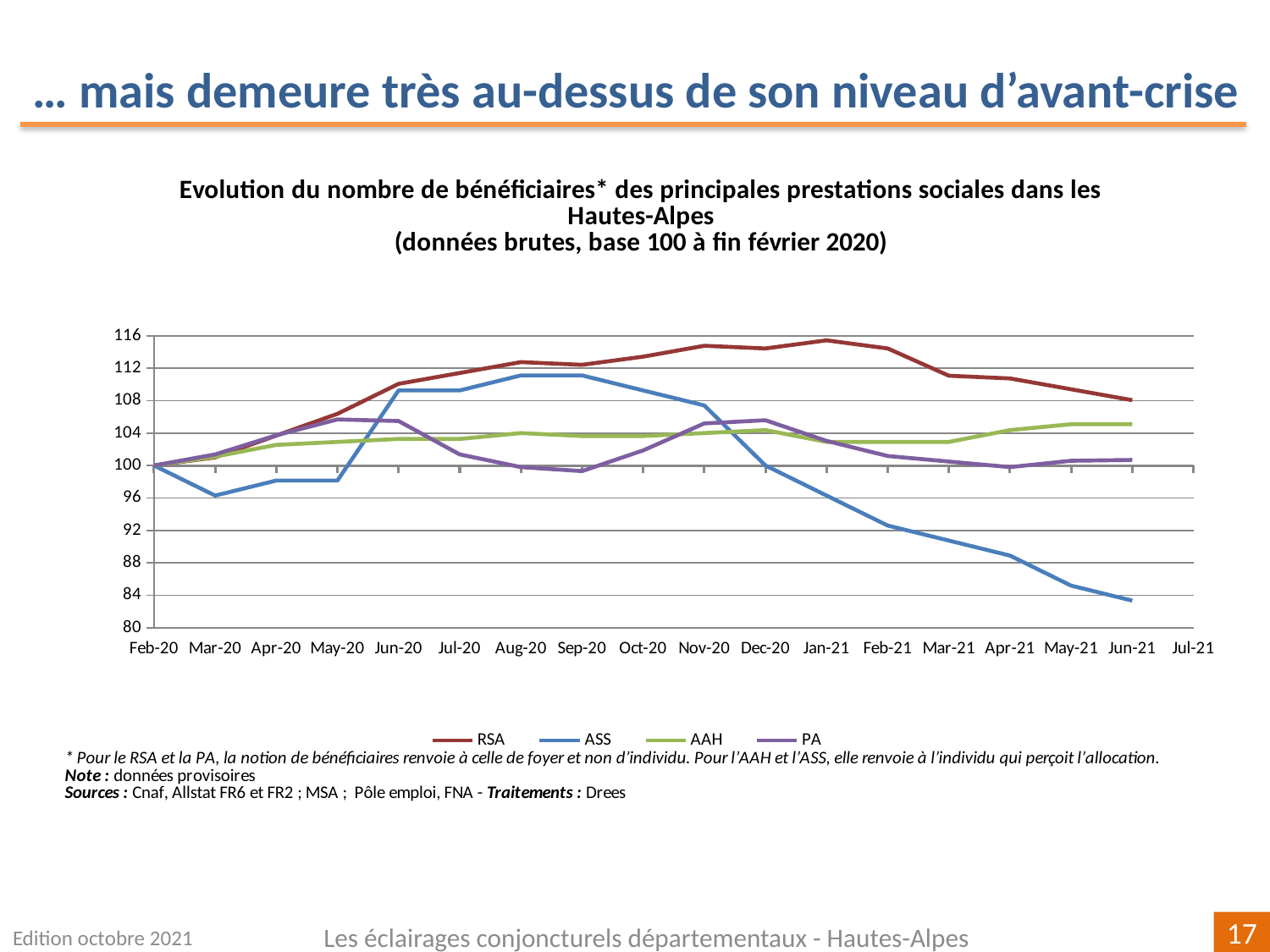
Is the value for ASS in Mar-20 greater or less than 100? less How many series does the legend list? 4 What kind of chart is shown on the slide? line chart Which series are listed in the legend? RSA, ASS, AAH, PA Is the value for ASS in Jun-21 greater or less than 88? less What is the value of the RSA series in Feb-20? 100 Is the value for RSA in Jan-21 greater or less than 112? greater Which series has the highest value in Jun-21? RSA How many month labels are shown on the x axis? 18 Which series has the lowest value in Jun-21? ASS In Dec-20, which is larger, the RSA value or the ASS value? RSA Does the ASS series rise or fall between Nov-20 and Jun-21? fall